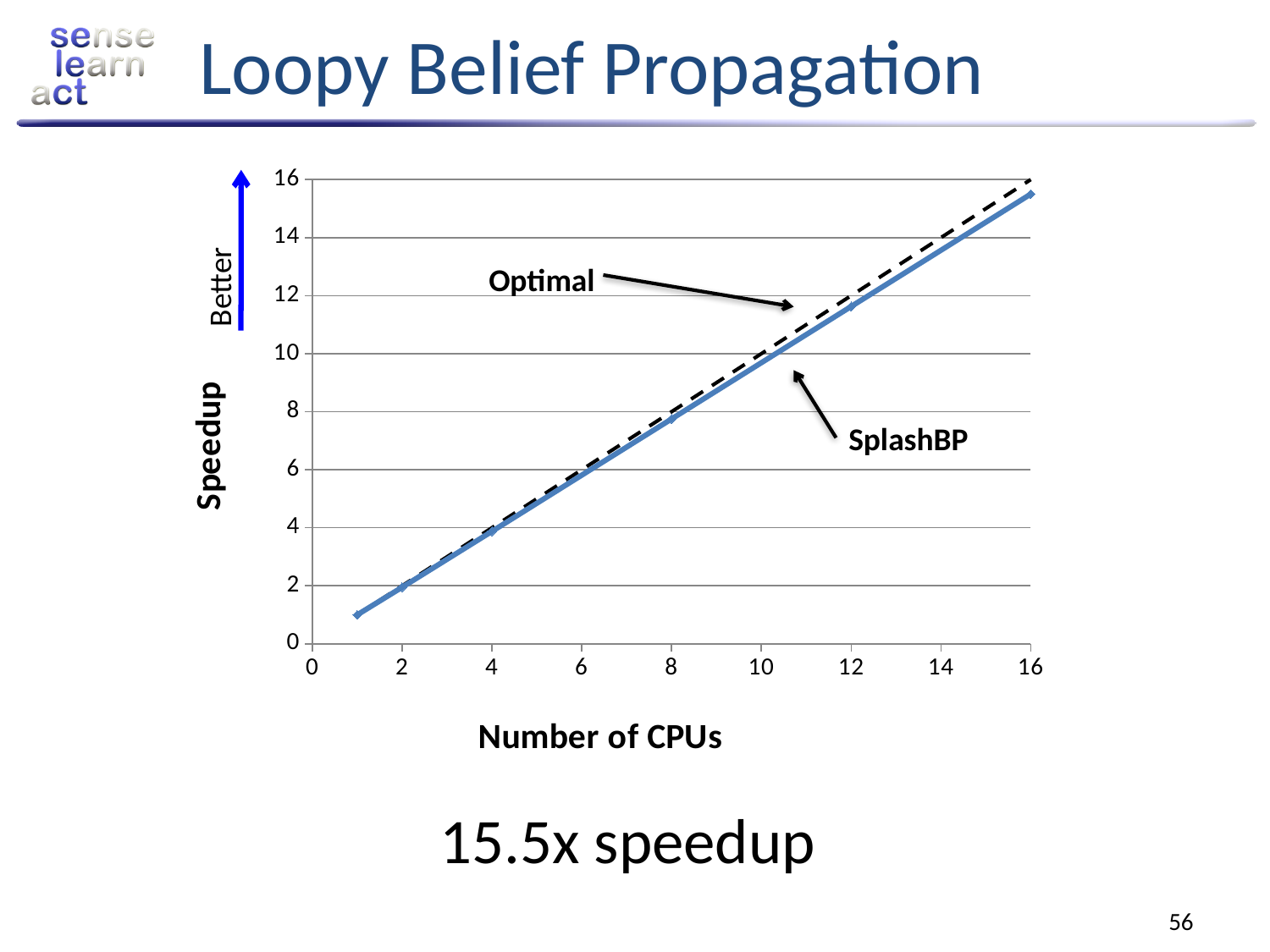
How many lines are plotted on the chart? 2 What speedup does the slide report for SplashBP at 16 CPUs? 15.5x Is the SplashBP speedup at 8 CPUs greater or less than 10? less Is the SplashBP speedup at 12 CPUs greater or less than 10? greater What is the title of the x axis? Number of CPUs At 16 CPUs, which line is higher, Optimal or SplashBP? Optimal What is the highest value shown on the x axis? 16 Is the SplashBP speedup at 4 CPUs greater or less than 6? less What kind of chart is shown on the slide? line chart Does the SplashBP speedup rise or fall as the number of CPUs increases? rises Which series is drawn as a dashed line? Optimal